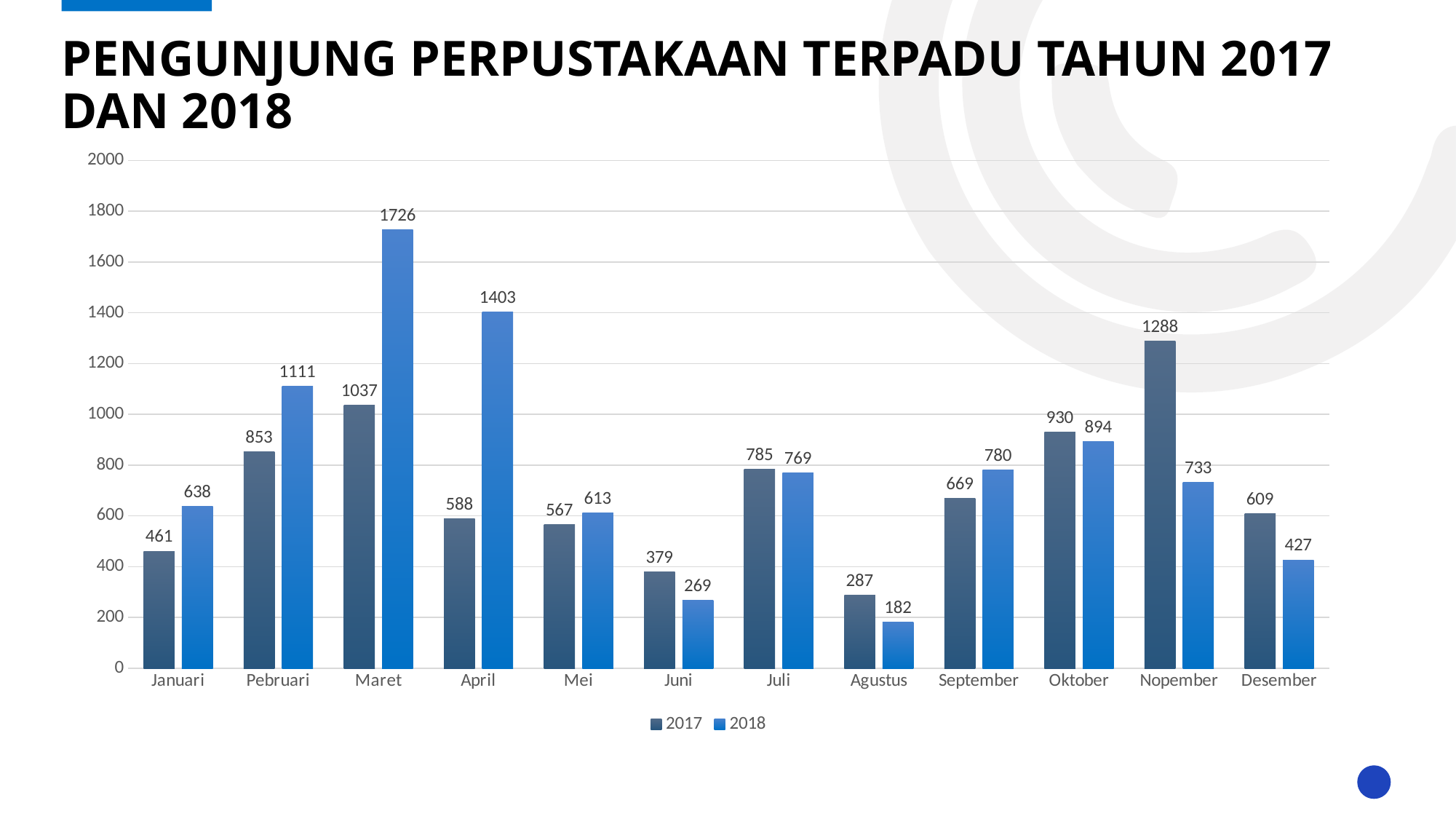
What is the difference between the 2018 and 2017 values in April? 815 Which month has the lowest value for 2017? Agustus Is the value for 2017 in Nopember greater or less than 1200? greater What is the value for 2018 in Agustus? 182 What is the title of the slide? PENGUNJUNG PERPUSTAKAAN TERPADU TAHUN 2017 DAN 2018 Which month has the highest value for 2018? Maret What kind of chart is shown on the slide? bar chart How many series does the legend list? 2 What is the value for 2018 in Nopember? 733 How many months are shown on the x axis? 12 What is the value for 2017 in Maret? 1037 Which is larger in Desember, the 2017 value or the 2018 value? 2017